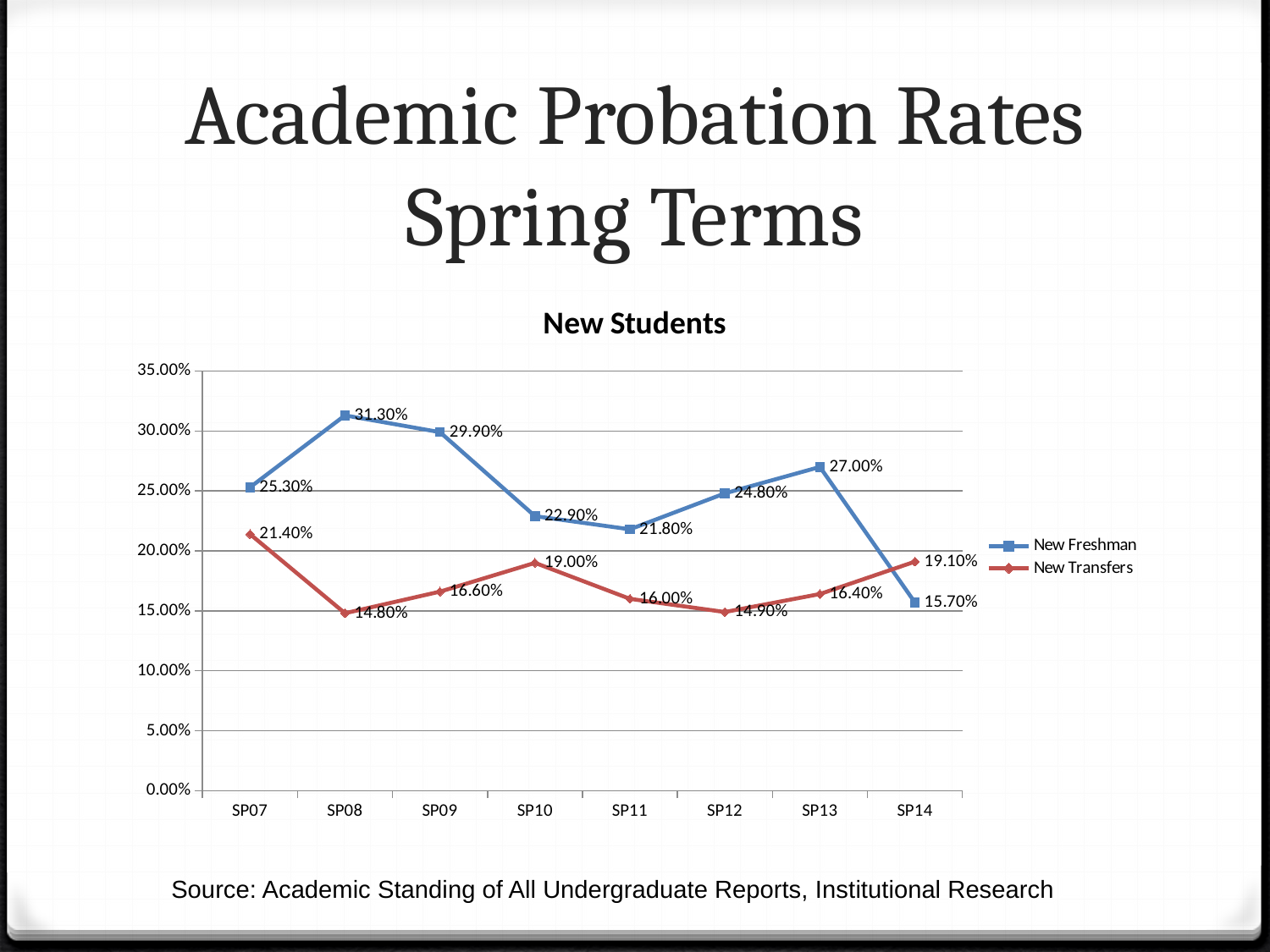
How many series does the legend list? 2 What is the title of the chart? New Students What is the New Freshman probation rate for SP11? 21.80% What is the New Freshman academic probation rate for SP08? 31.30% In which spring term is the New Transfers probation rate lowest? SP08 What is the New Transfers academic probation rate for SP10? 19.00% How many spring terms are shown on the x axis? 8 Which series has the higher probation rate in SP14, New Freshman or New Transfers? New Transfers What is the difference between the New Freshman and New Transfers probation rates in SP07? 3.90% What kind of chart is shown on the slide? Line chart Does the New Freshman probation rate rise or fall from SP13 to SP14? Fall In which spring term is the New Freshman probation rate highest? SP08